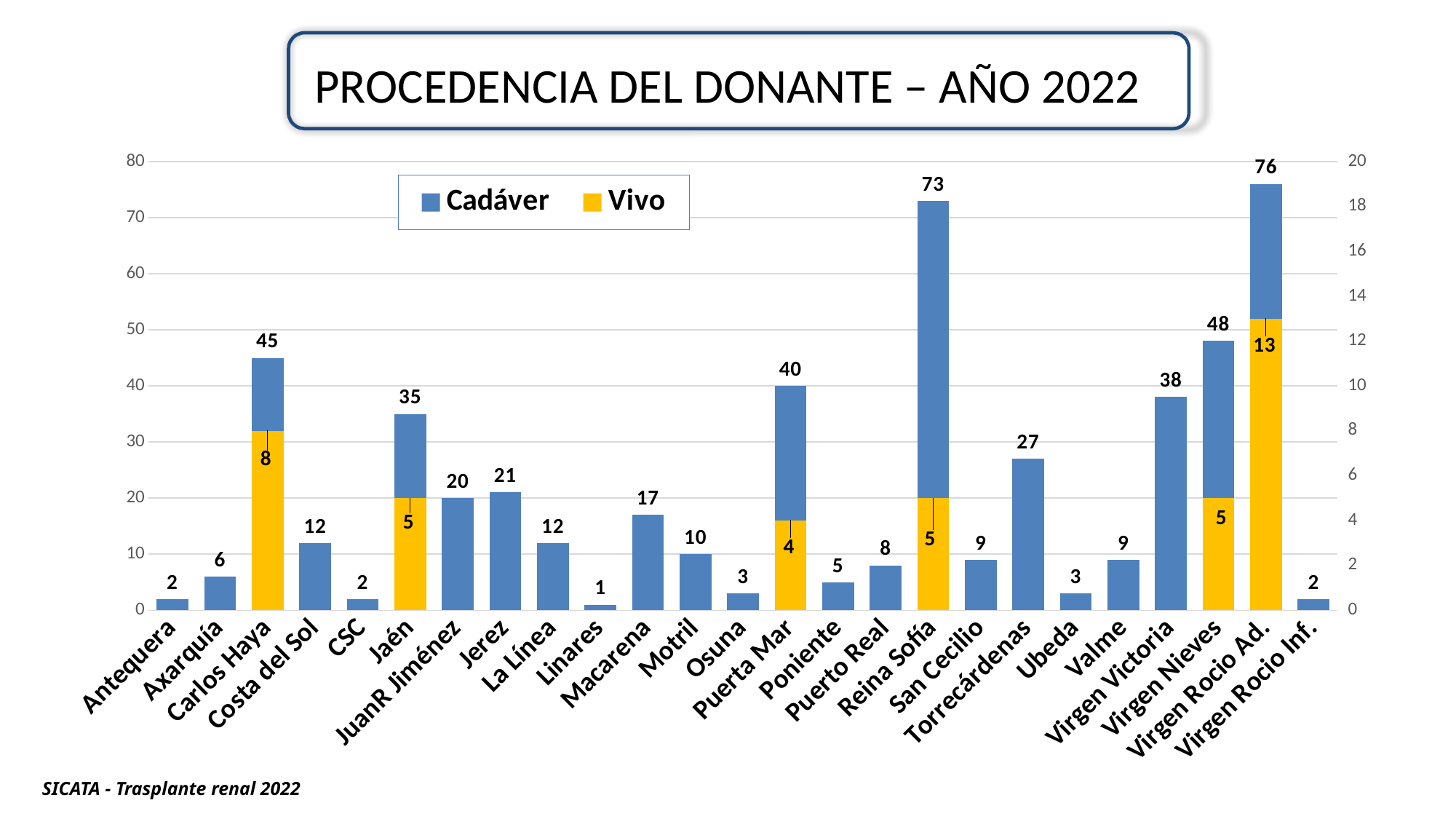
What is the Vivo value for Carlos Haya? 8 What is the Vivo value for Virgen Rocio Ad.? 13 What is the title of the chart? PROCEDENCIA DEL DONANTE – AÑO 2022 How many series does the legend list? 2 Which category has the shortest bar? Linares Which has the larger value labelled at the top of its bar, Carlos Haya or Puerta Mar? Carlos Haya Which category has the tallest bar? Virgen Rocio Ad. What is the Cadáver value for Torrecárdenas? 27 How many categories are shown on the x axis? 25 What is the difference between the values labelled at the top of the bars for Virgen Rocio Ad. and Reina Sofía? 3 What value is labelled at the top of the bar for Reina Sofía? 73 What kind of chart is shown on the slide? bar chart